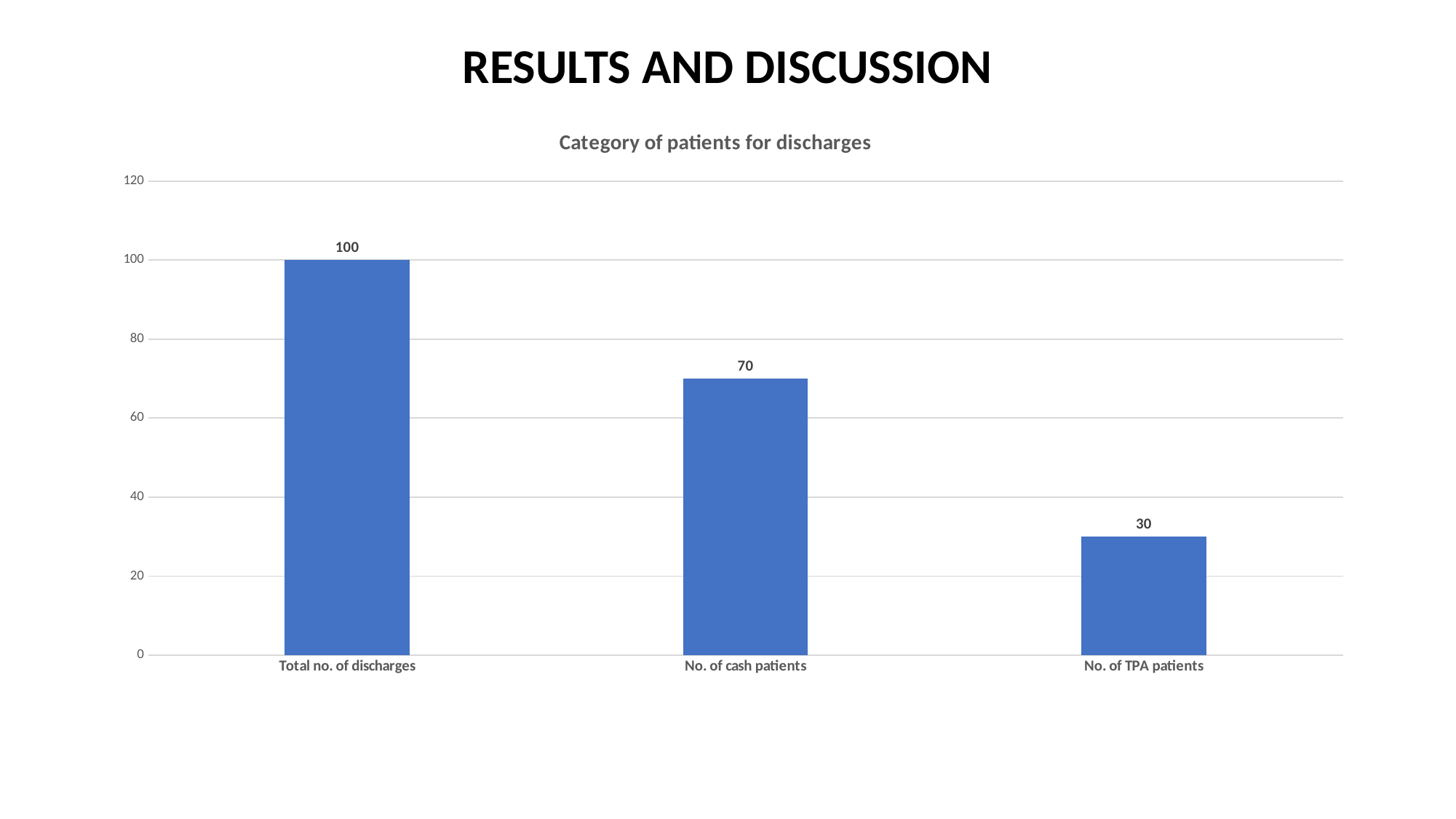
Which category has the lowest value? No. of TPA patients What is the value for Total no. of discharges? 100 How many categories are shown on the chart? 3 What is the title of the chart? Category of patients for discharges What is the value for No. of TPA patients? 30 What is the difference between Total no. of discharges and No. of cash patients? 30 What kind of chart is shown on the slide? bar chart Which is larger, No. of cash patients or No. of TPA patients? No. of cash patients What is the value for No. of cash patients? 70 Is the value for No. of TPA patients greater or less than 40? less What is the difference between No. of cash patients and No. of TPA patients? 40 Which category has the highest value? Total no. of discharges